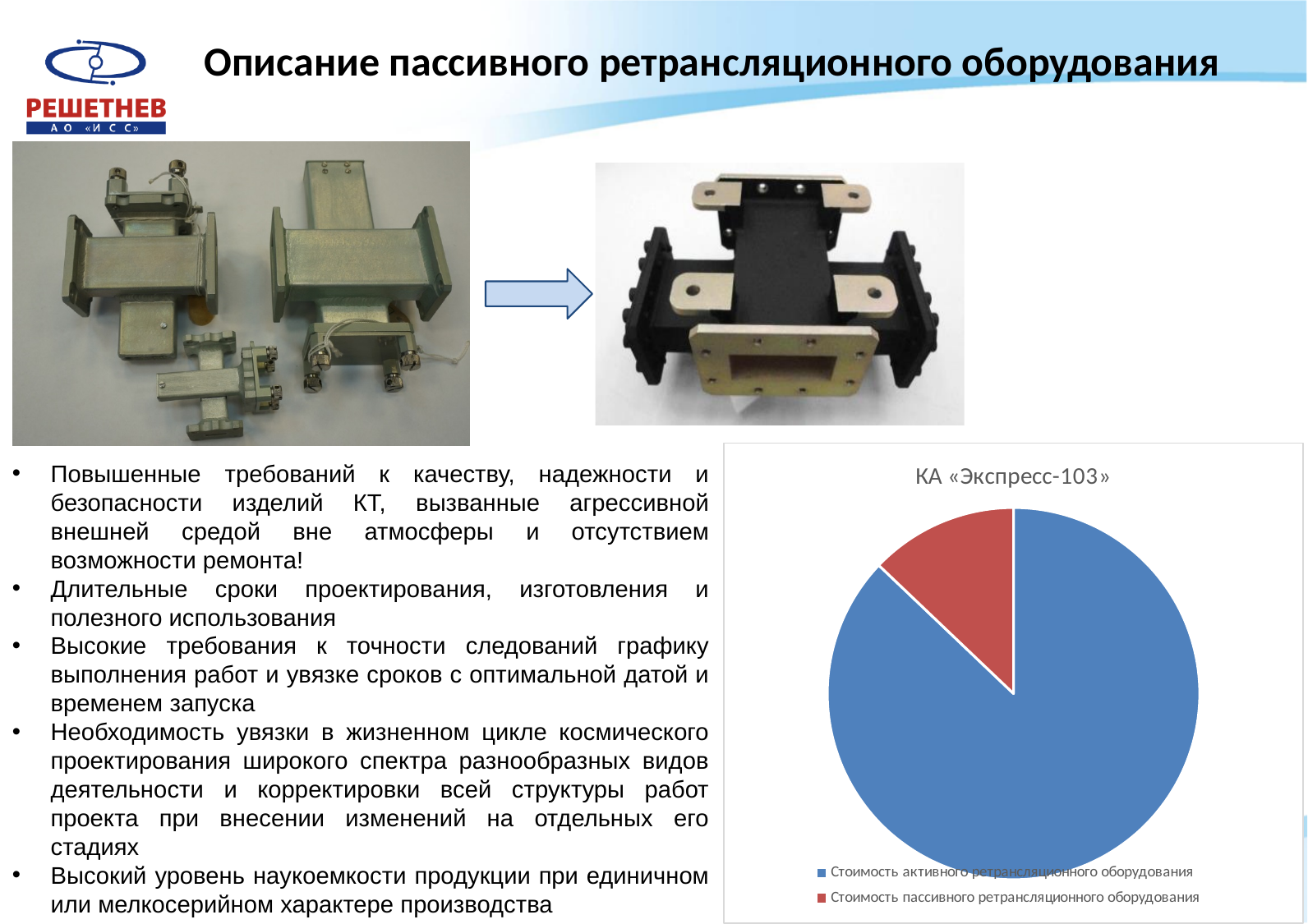
What is the title of the pie chart? КА «Экспресс-103» What colour represents 'Стоимость пассивного ретрансляционного оборудования' in the pie chart? red How many entries does the legend of the pie chart list? 2 What kind of chart is shown on the slide? pie chart Which category takes the smallest share of the pie chart? Стоимость пассивного ретрансляционного оборудования Which category takes the largest share of the pie chart? Стоимость активного ретрансляционного оборудования Which is larger in the pie chart: the cost of active relay equipment or the cost of passive relay equipment? Стоимость активного ретрансляционного оборудования How many slices does the pie chart have? 2